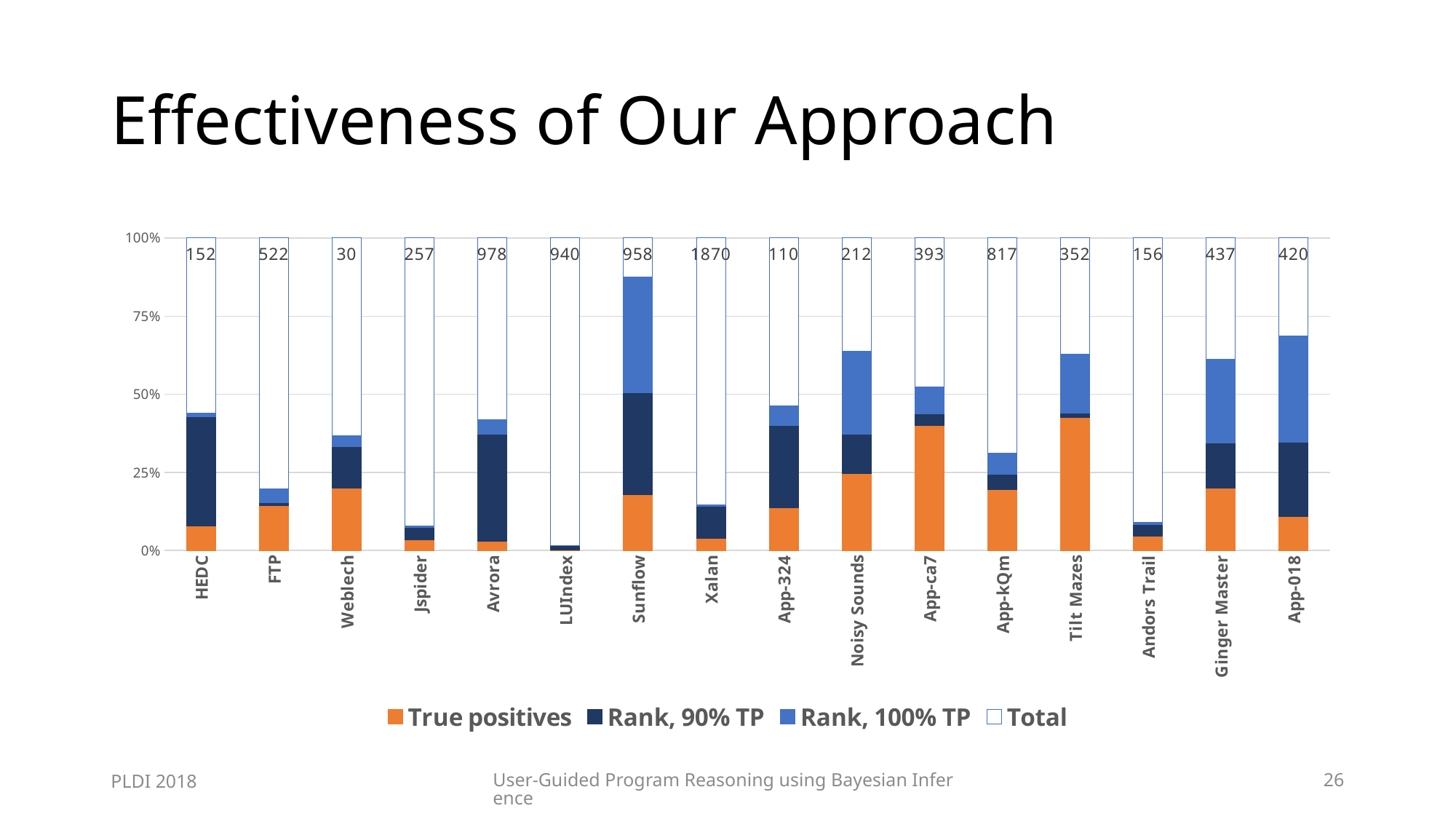
What total is printed above the bar for Weblech? 30 Is the top of the Rank, 100% TP segment for Sunflow greater or less than 75%? greater How many series does the legend list? 4 Is the True positives value for Tilt Mazes greater or less than 25%? greater How many categories are shown on the x axis? 16 Which category has the lowest printed total? Weblech Which category has the highest printed total? Xalan What total is printed above the bar for Xalan? 1870 Which has a larger printed total, Sunflow or LUIndex? Sunflow What total is printed above the bar for Avrora? 978 What kind of chart is shown on the slide? Stacked bar chart What is the difference between the printed totals for FTP and HEDC? 370